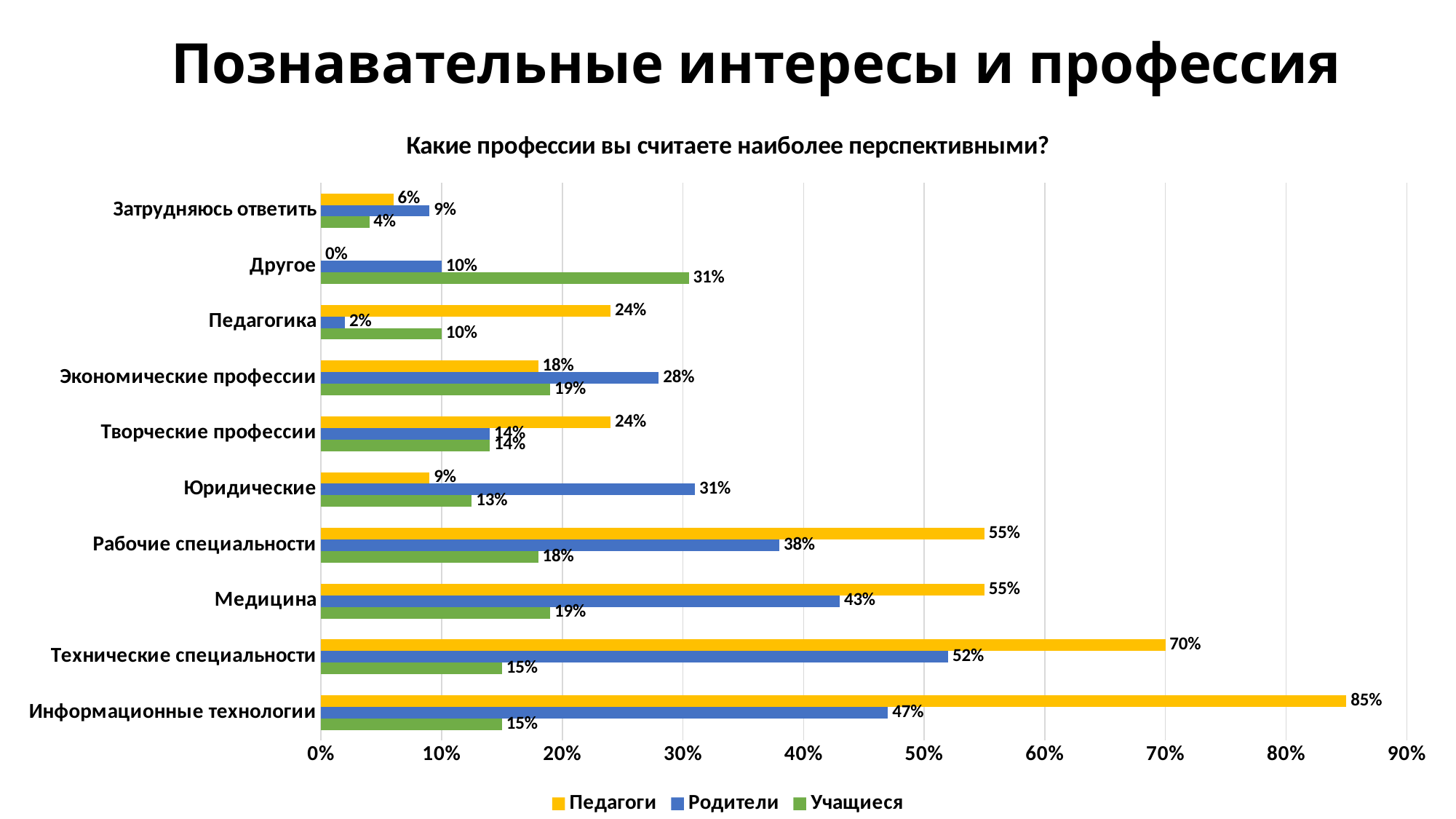
How many profession categories are shown on the chart? 10 What is the value for Родители in the Юридические category? 31% What is the value for Учащиеся in the Другое category? 31% Which colour represents the Учащиеся series in the chart? Green Which category has the highest value for the Родители series? Технические специальности For Медицина, which series has the larger value: Родители or Учащиеся? Родители What is the difference between the Педагоги and Родители values for Технические специальности? 18% Which category has the lowest value for the Педагоги series? Другое What percentage of Педагоги chose Информационные технологии as a promising profession? 85% How many series does the legend list? 3 What is the difference between the Педагоги and Учащиеся values for Рабочие специальности? 37% What type of chart is shown on the slide? Bar chart